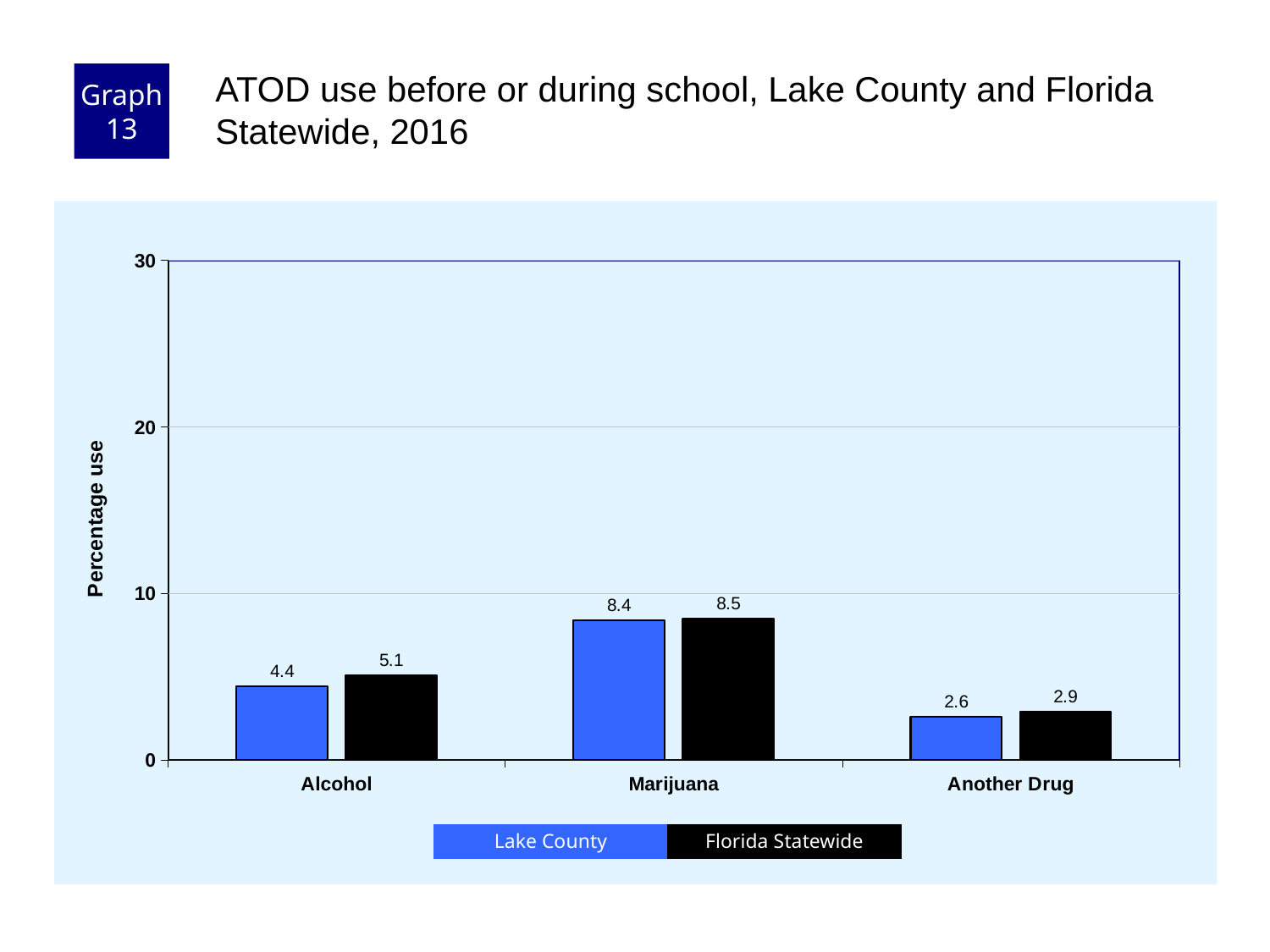
What is the difference between the Florida Statewide and Lake County values for Alcohol? 0.7 What kind of chart is shown on the slide? bar chart What is the Lake County value for Alcohol? 4.4 Is the Florida Statewide value for Marijuana greater or less than 10? less Which category has the lowest Florida Statewide value? Another Drug What is the Florida Statewide value for Alcohol? 5.1 How many series does the legend list? 2 What is the Lake County value for Another Drug? 2.6 Which category has the highest Lake County value? Marijuana How many categories are shown on the x axis? 3 Which is larger for Another Drug, the Lake County value or the Florida Statewide value? Florida Statewide What is the Florida Statewide value for Marijuana? 8.5